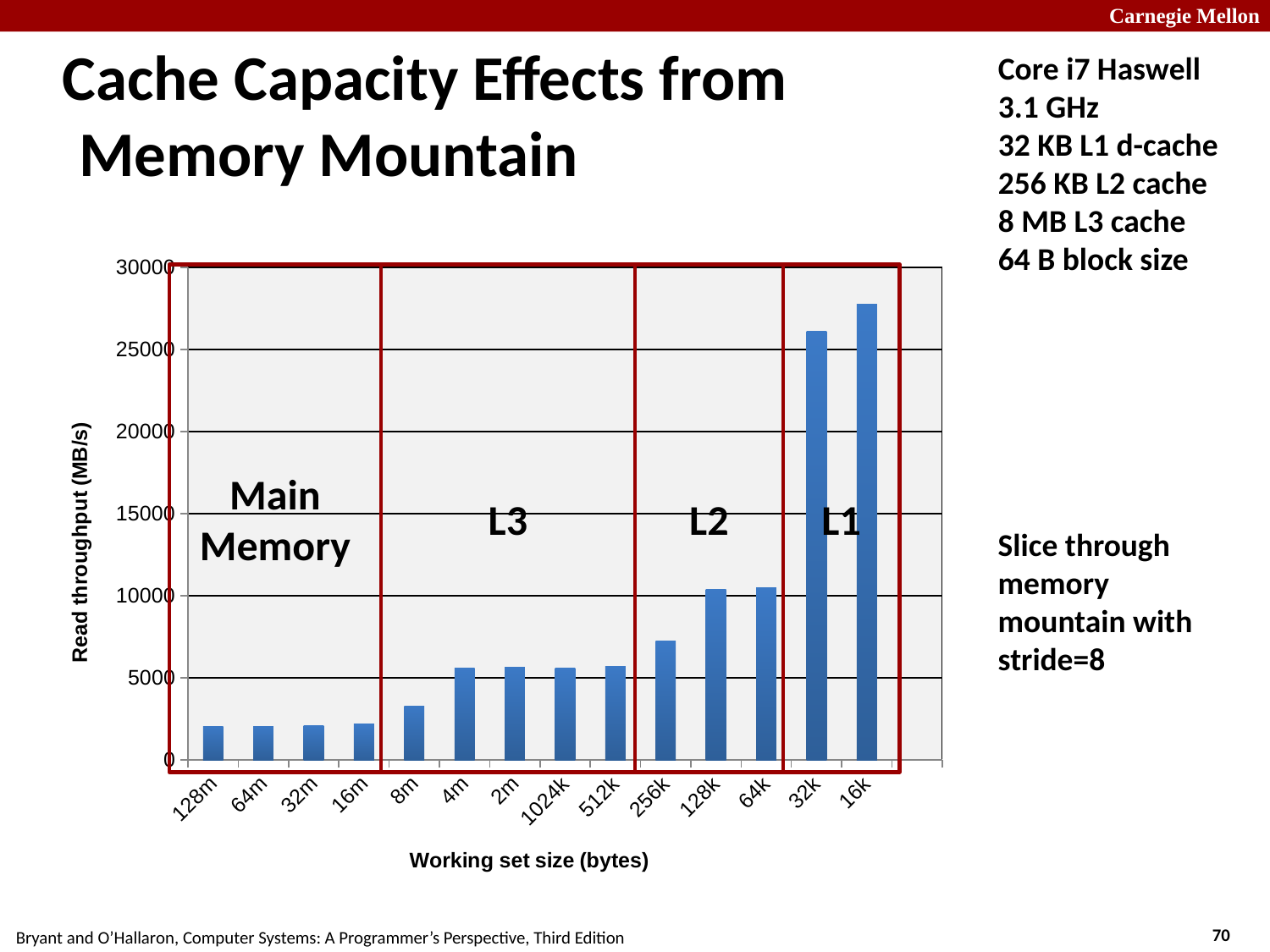
Is the read throughput for a working set size of 256k greater or less than 10000 MB/s? less Is the read throughput for a working set size of 128m greater or less than 5000 MB/s? less What kind of chart is shown on the slide? bar chart Do the read throughput values generally rise or fall moving from left to right along the x axis? rise Which has the higher read throughput: a working set size of 256k or 8m? 256k How many working set sizes are plotted along the x axis? 14 Which memory level label is shown over the region containing the two rightmost bars? L1 Which has the higher read throughput: a working set size of 16k or 32k? 16k Which working set size has the highest read throughput? 16k Is the read throughput for a working set size of 8m greater or less than 5000 MB/s? less What is the label of the y axis? Read throughput (MB/s)